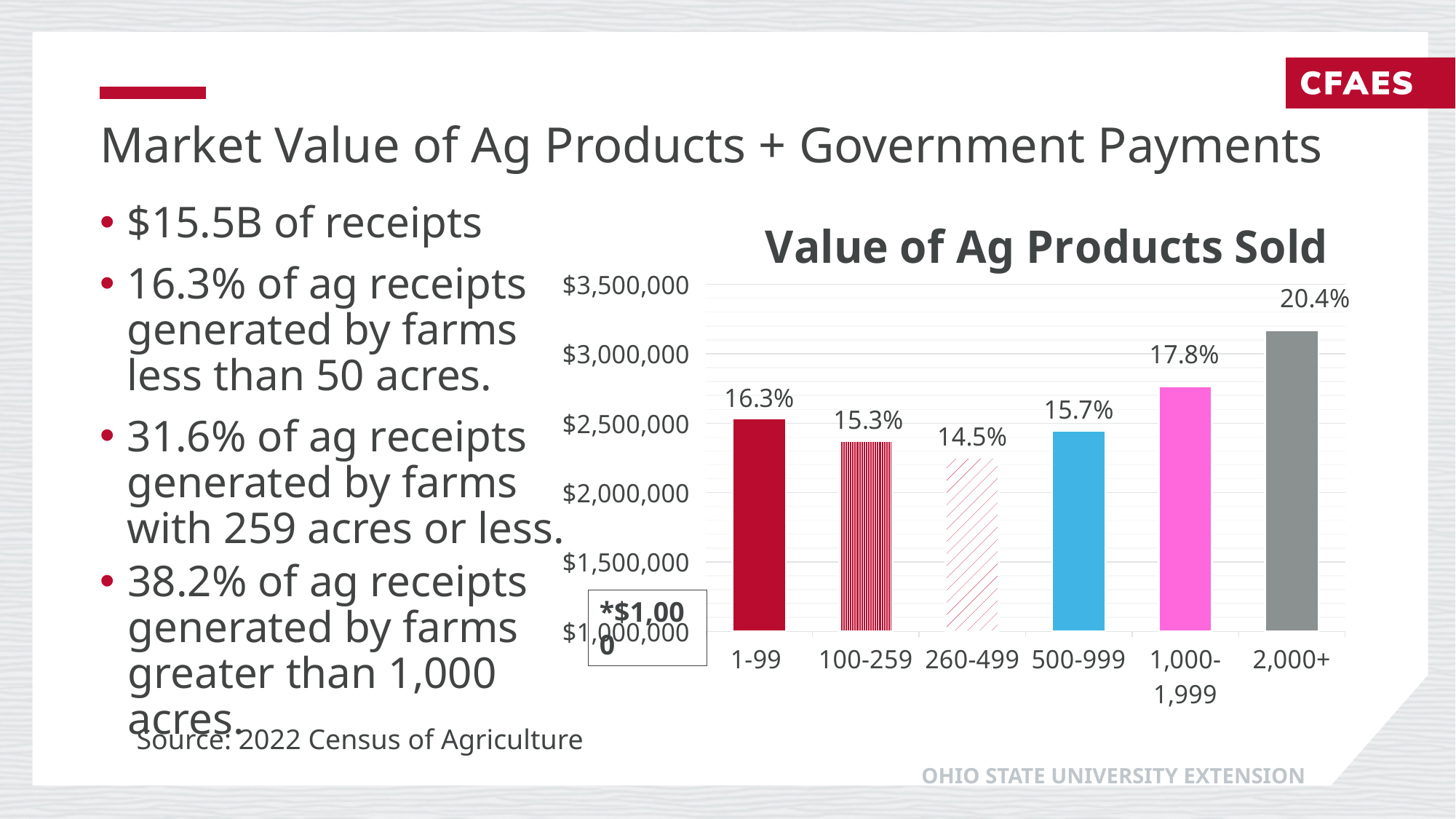
What kind of chart is shown on the slide? bar chart What is the difference in percentage points between the labels for 2,000+ and 260-499? 5.9 What is the title of the chart? Value of Ag Products Sold What data label is shown on the bar for the 1-99 category? 16.3% What data label is shown on the bar for the 1,000-1,999 category? 17.8% Do the bar values rise or fall from 260-499 through 2,000+? rise What data label is shown on the bar for the 260-499 category? 14.5% How many farm-size categories are shown on the x axis of the chart? 6 Which category has the highest bar in the chart? 2,000+ Is the value for 2,000+ greater or less than $3,000,000? greater Which bar is taller, 1-99 or 500-999? 1-99 Which category has the lowest bar in the chart? 260-499